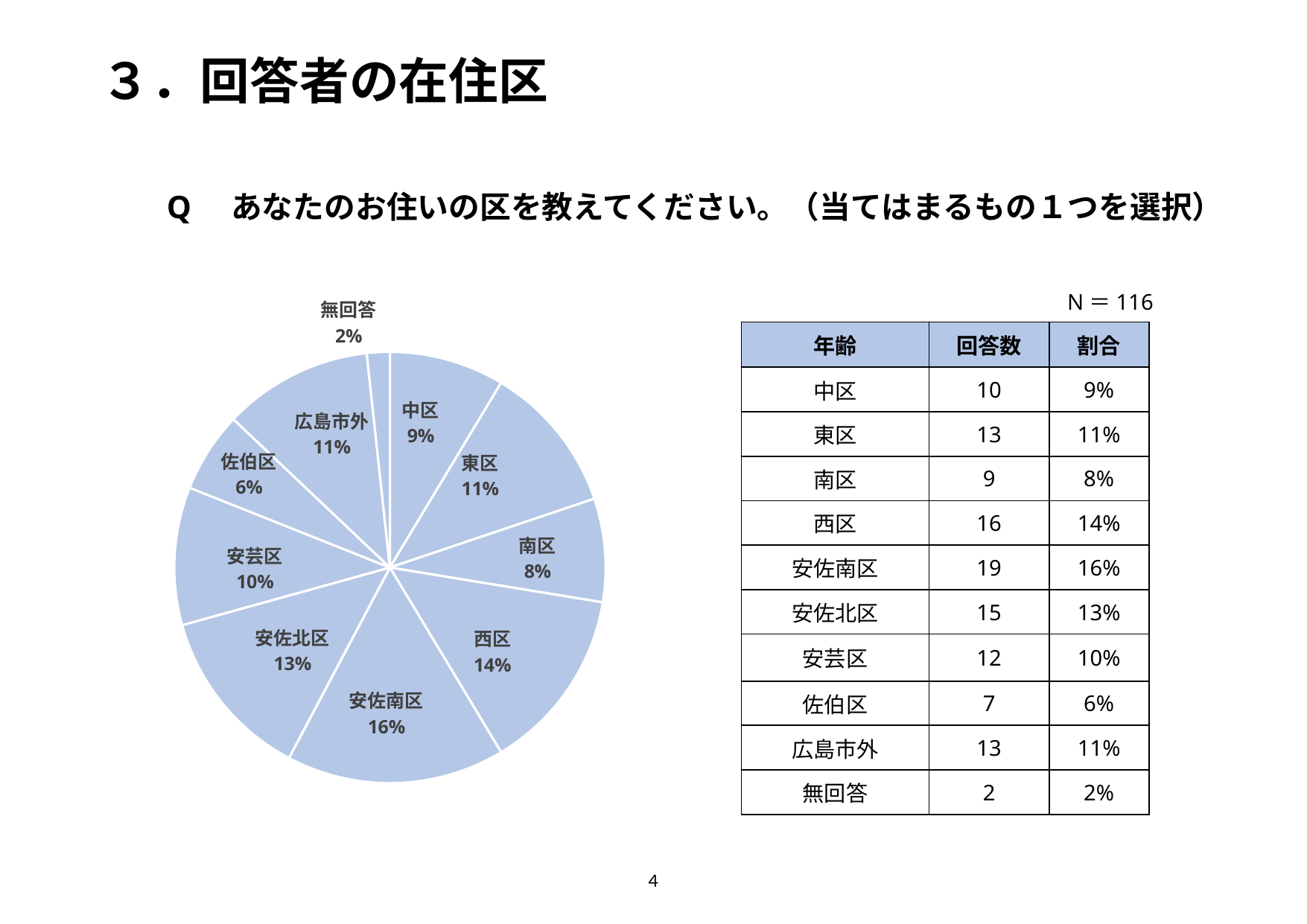
How many slices does the pie chart have? 10 What is the difference in percentage points between 西区 and 南区 in the pie chart? 6 Which is larger in the pie chart, 安佐北区 or 安芸区? 安佐北区 What share of the pie does 安佐南区 represent? 16% What kind of chart is shown on the slide? pie chart Which slice of the pie chart is the smallest? 無回答 What share of the pie does 西区 represent? 14% Are the slices of the pie chart shown in different colours or all in the same colour? all in the same colour Which is larger in the pie chart, 中区 or 東区? 東区 Which slice of the pie chart is the largest? 安佐南区 What is the value shown for 広島市外 in the pie chart? 11% What is the value shown for 佐伯区 in the pie chart? 6%